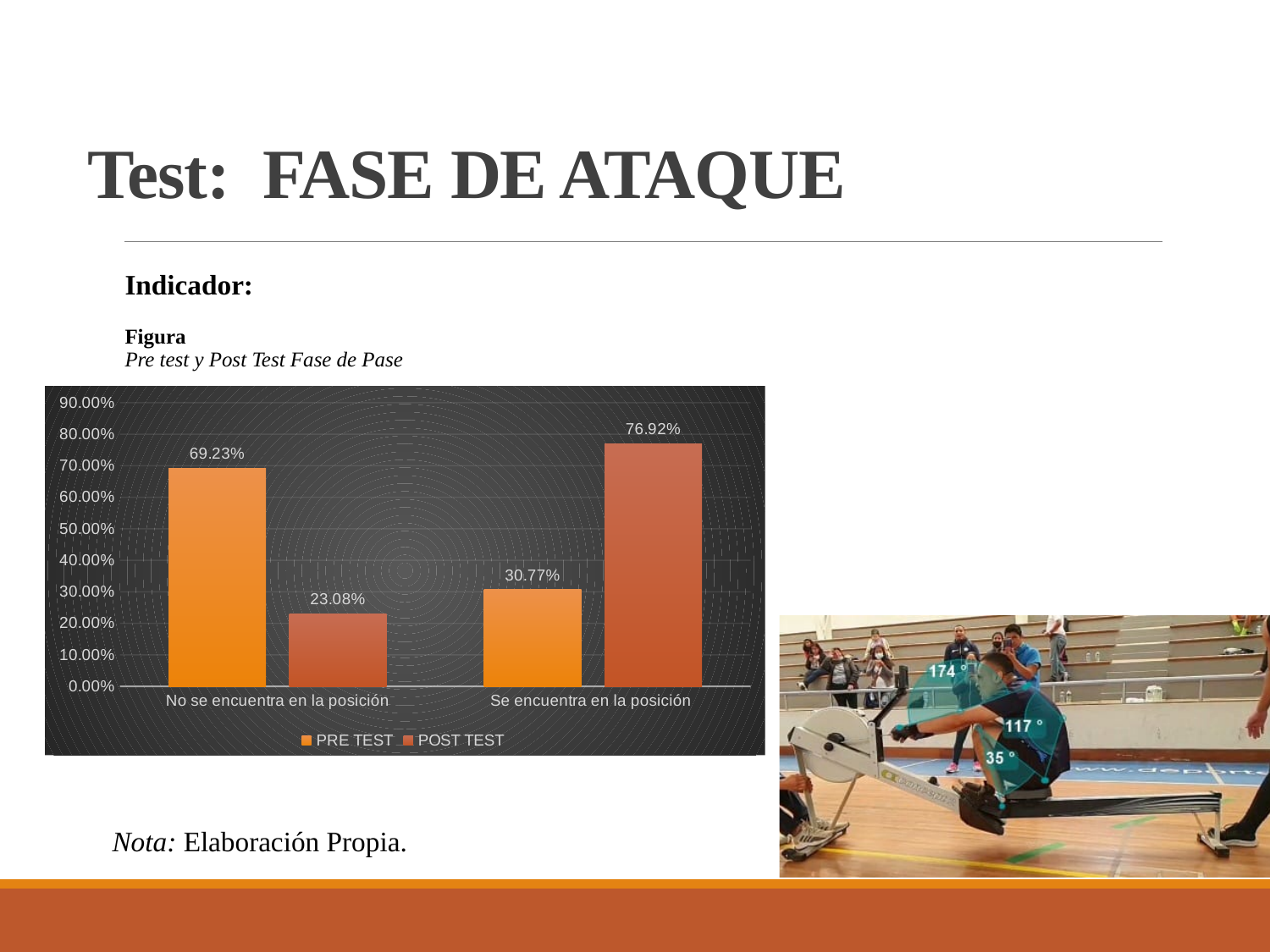
What type of chart is shown on the slide? Bar chart What is the PRE TEST value for 'No se encuentra en la posición'? 69.23% What is the POST TEST value for 'No se encuentra en la posición'? 23.08% Which bar has the highest value in the chart? POST TEST, Se encuentra en la posición Which bar has the lowest value in the chart? POST TEST, No se encuentra en la posición How many categories are shown on the x axis? 2 What is the difference between the POST TEST and PRE TEST values for 'Se encuentra en la posición'? 46.15% Which is larger for 'No se encuentra en la posición': PRE TEST or POST TEST? PRE TEST How many series does the legend list? 2 What is the PRE TEST value for 'Se encuentra en la posición'? 30.77% What are the two series named in the legend? PRE TEST and POST TEST What is the POST TEST value for 'Se encuentra en la posición'? 76.92%